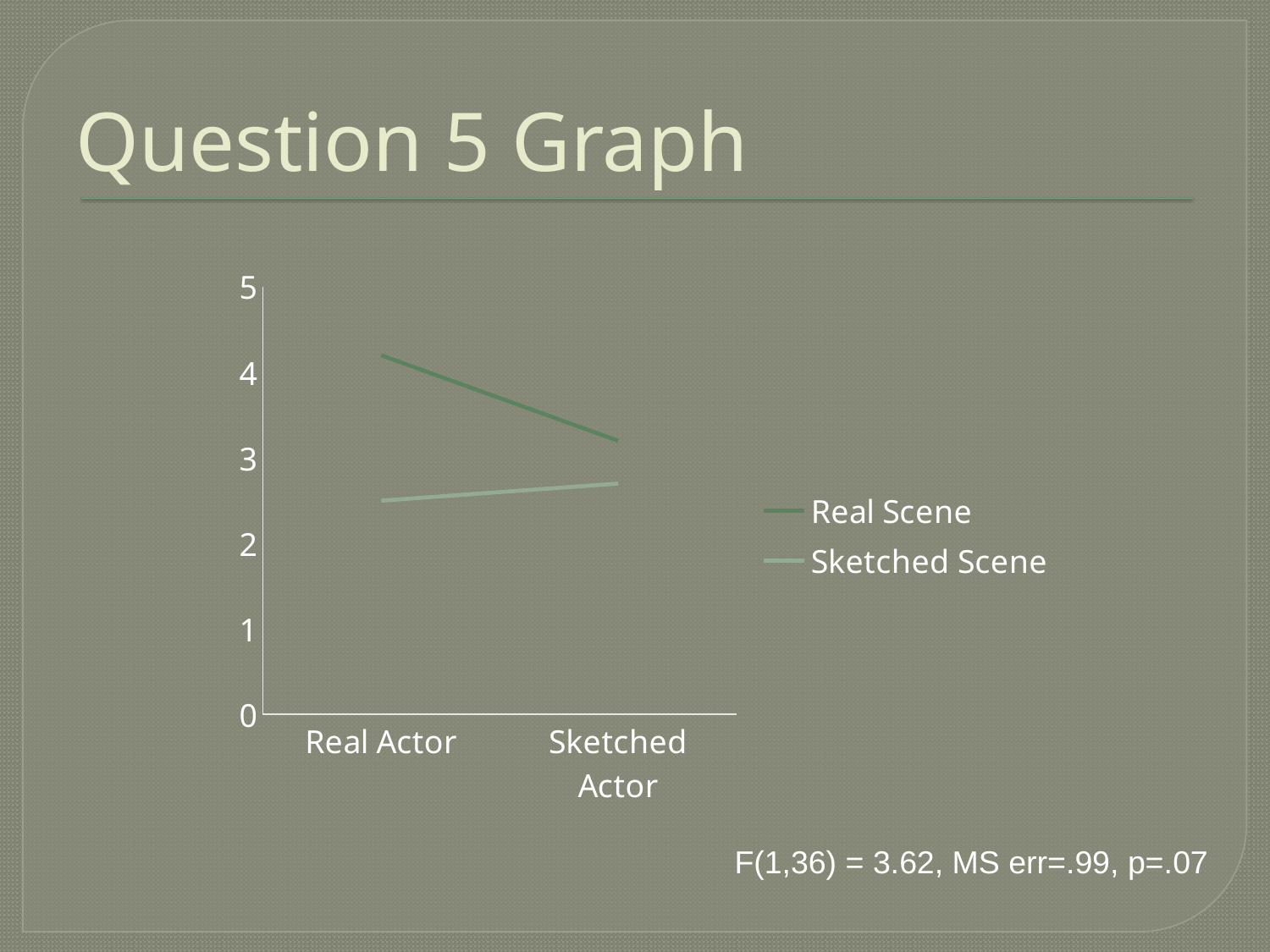
Is the value for Sketched Scene at Real Actor greater or less than 3? less Is the value for Sketched Scene at Sketched Actor greater or less than 3? less At Real Actor, which series has the higher value, Real Scene or Sketched Scene? Real Scene Is the value for Real Scene at Real Actor greater or less than 4? greater What is the title of the slide containing the chart? Question 5 Graph What kind of chart is shown on the slide? line chart How many categories are shown on the x axis? 2 At Sketched Actor, which series has the higher value, Real Scene or Sketched Scene? Real Scene Does the Sketched Scene line rise or fall from Real Actor to Sketched Actor? rise Does the Real Scene line rise or fall from Real Actor to Sketched Actor? fall How many series does the legend list? 2